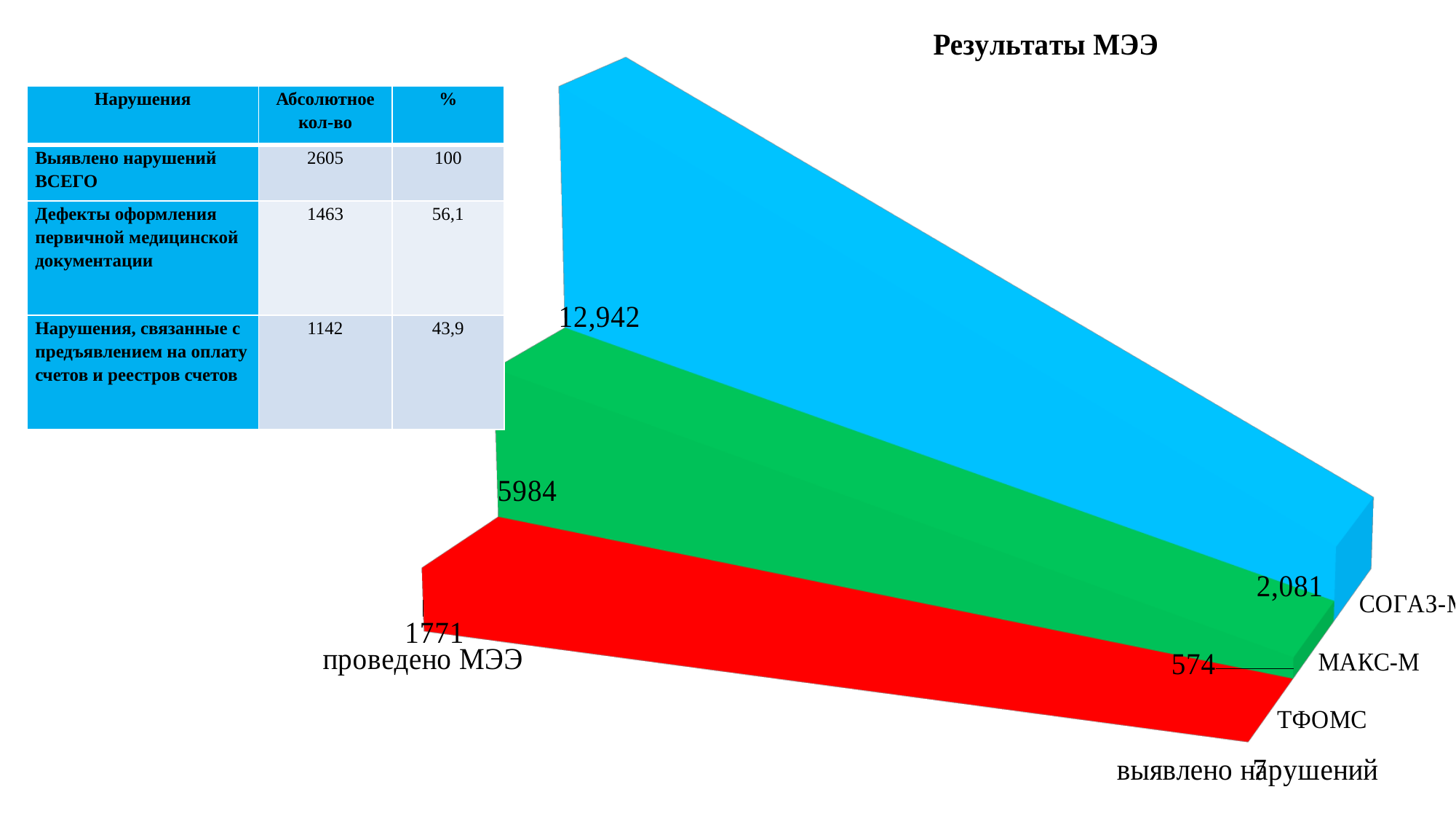
What is the title of the chart? Результаты МЭЭ What is the value for ТФОМС at "проведено МЭЭ"? 1771 What is the value for СОГАЗ-М at "проведено МЭЭ"? 12,942 Which series has the lowest value at "проведено МЭЭ"? ТФОМС Which is larger for МАКС-М: the value at "проведено МЭЭ" or at "выявлено нарушений"? проведено МЭЭ What is the difference between the "проведено МЭЭ" values for СОГАЗ-М and МАКС-М? 6958 What is the value for МАКС-М at "выявлено нарушений"? 574 What is the value for МАКС-М at "проведено МЭЭ"? 5984 How many series are plotted on the chart? 3 What is the value for СОГАЗ-М at "выявлено нарушений"? 2,081 What is the difference between the "выявлено нарушений" values for СОГАЗ-М and МАКС-М? 1507 Which series has the highest value at "проведено МЭЭ"? СОГАЗ-М